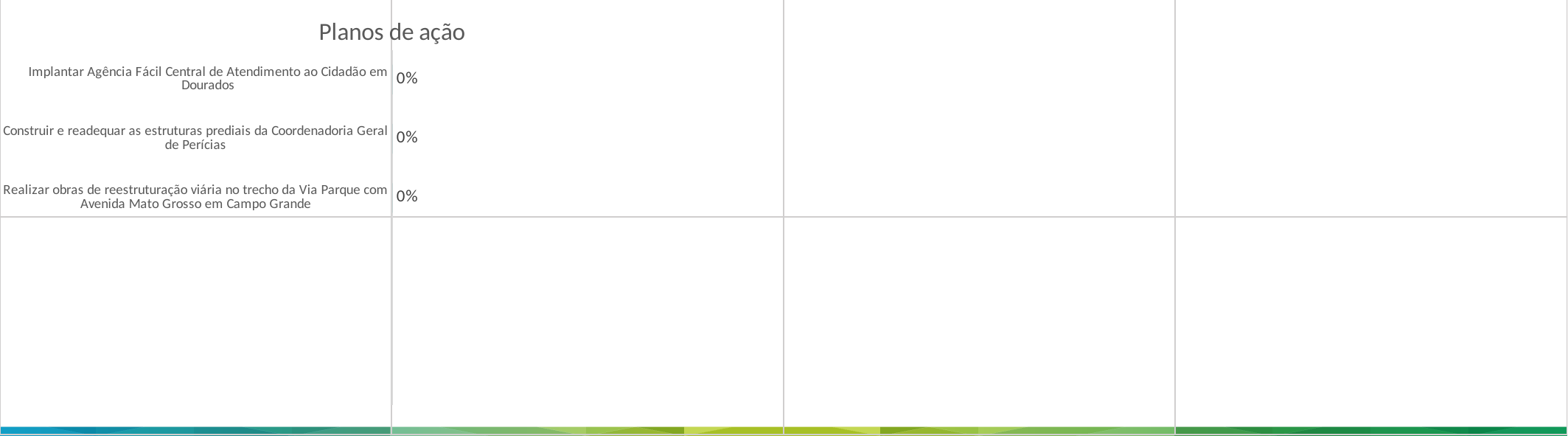
Which category is listed first (at the top) in the chart? Implantar Agência Fácil Central de Atendimento ao Cidadão em Dourados What kind of chart is shown on the slide? bar chart What is the difference between the value for "Implantar Agência Fácil Central de Atendimento ao Cidadão em Dourados" and the value for "Construir e readequar as estruturas prediais da Coordenadoria Geral de Perícias"? 0% What value is shown for "Realizar obras de reestruturação viária no trecho da Via Parque com Avenida Mato Grosso em Campo Grande"? 0% How many categories (action plans) are listed in the chart? 3 Is the value for "Realizar obras de reestruturação viária no trecho da Via Parque com Avenida Mato Grosso em Campo Grande" greater than 0%? No What value is shown for "Construir e readequar as estruturas prediais da Coordenadoria Geral de Perícias"? 0% What is the title of the chart? Planos de ação What value is shown for "Implantar Agência Fácil Central de Atendimento ao Cidadão em Dourados"? 0%